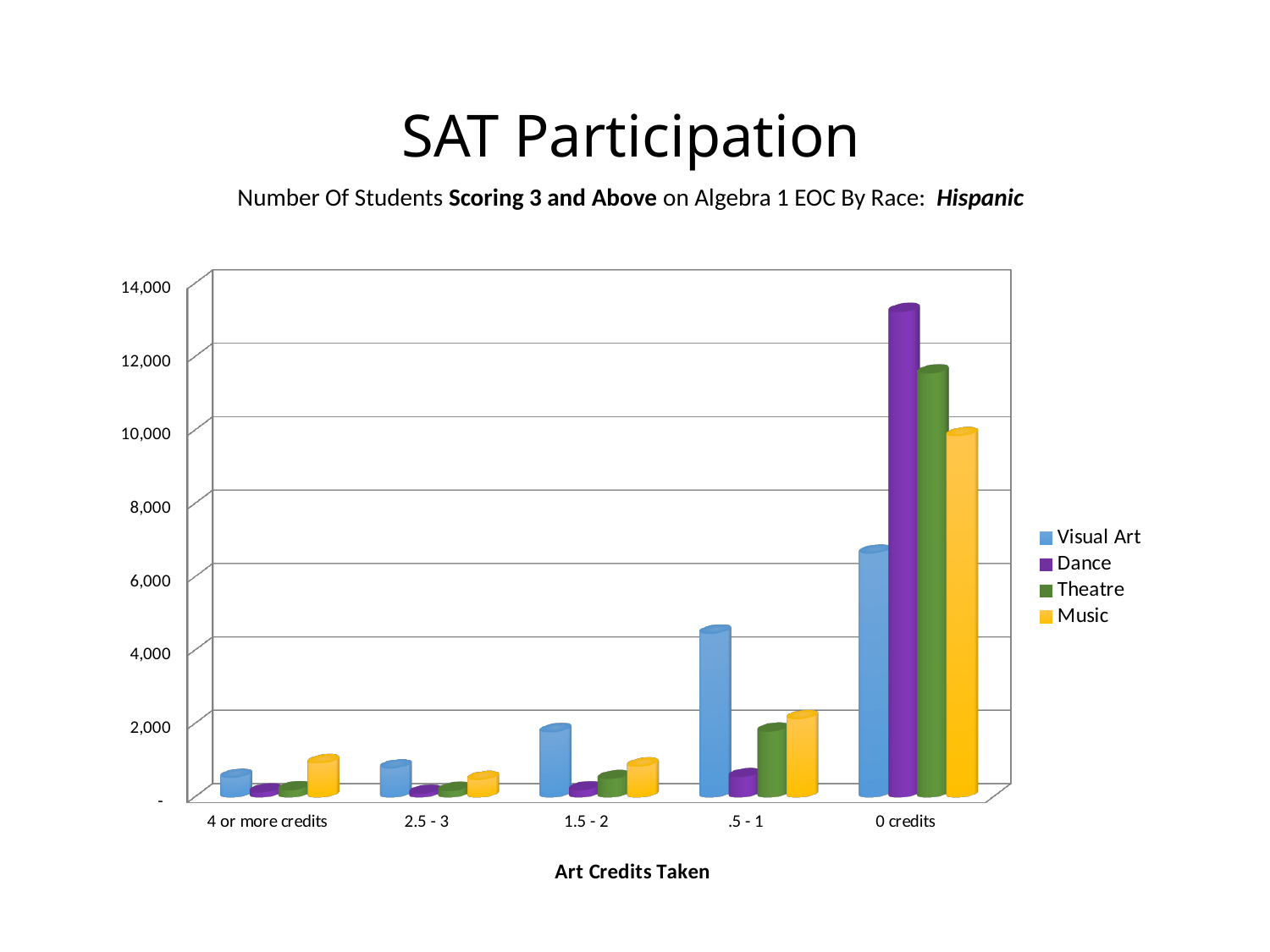
Which series has the lowest value in the .5 - 1 category? Dance Is the value for Dance in the 0 credits category greater or less than 12,000? greater What kind of chart is shown on the slide? bar chart How many art-credit categories are shown on the x axis? 5 Which series has the highest value in the 0 credits category? Dance What is the label of the x axis? Art Credits Taken In the 0 credits category, which is larger: Theatre or Music? Theatre In the .5 - 1 category, which is larger: Visual Art or Theatre? Visual Art Is the value for Visual Art in the 0 credits category greater or less than 8,000? less Is the value for Visual Art in the .5 - 1 category greater or less than 4,000? greater How many series does the legend list? 4